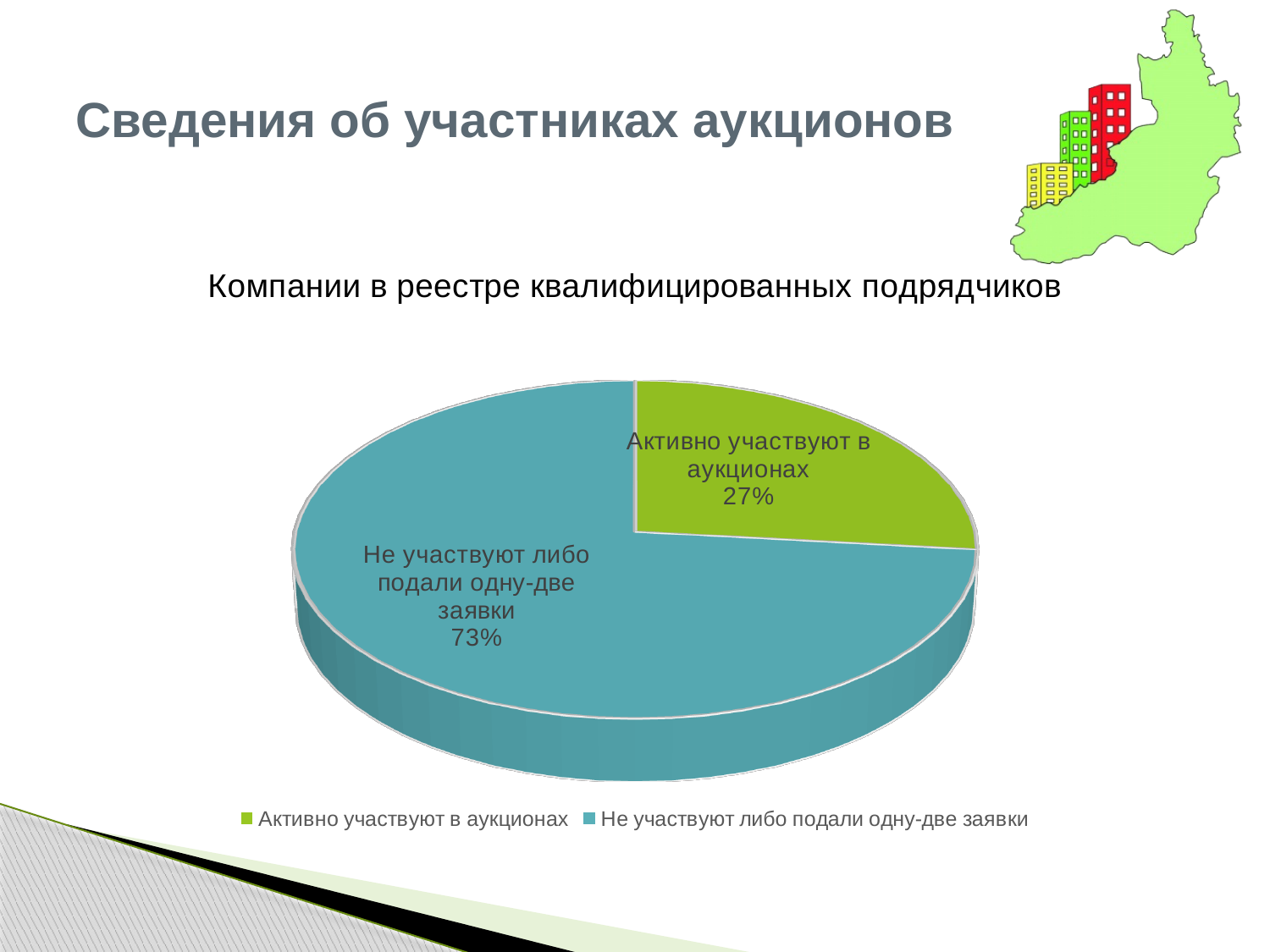
What share of companies in the register actively participate in auctions (Активно участвуют в аукционах)? 27% Which category has the largest share of the pie? Не участвуют либо подали одну-две заявки How many slices does the pie chart have? 2 Which is larger: the share of companies that actively participate in auctions or the share that do not participate or submitted one or two bids? Не участвуют либо подали одну-две заявки What kind of chart is shown on the slide? pie chart What share of companies do not participate or submitted only one or two bids (Не участвуют либо подали одну-две заявки)? 73% What colour is the slice for companies that actively participate in auctions? green What is the title of the chart? Компании в реестре квалифицированных подрядчиков Which category has the smallest share of the pie? Активно участвуют в аукционах What is the difference in percentage points between the two slices of the pie? 46 How many entries does the legend list? 2